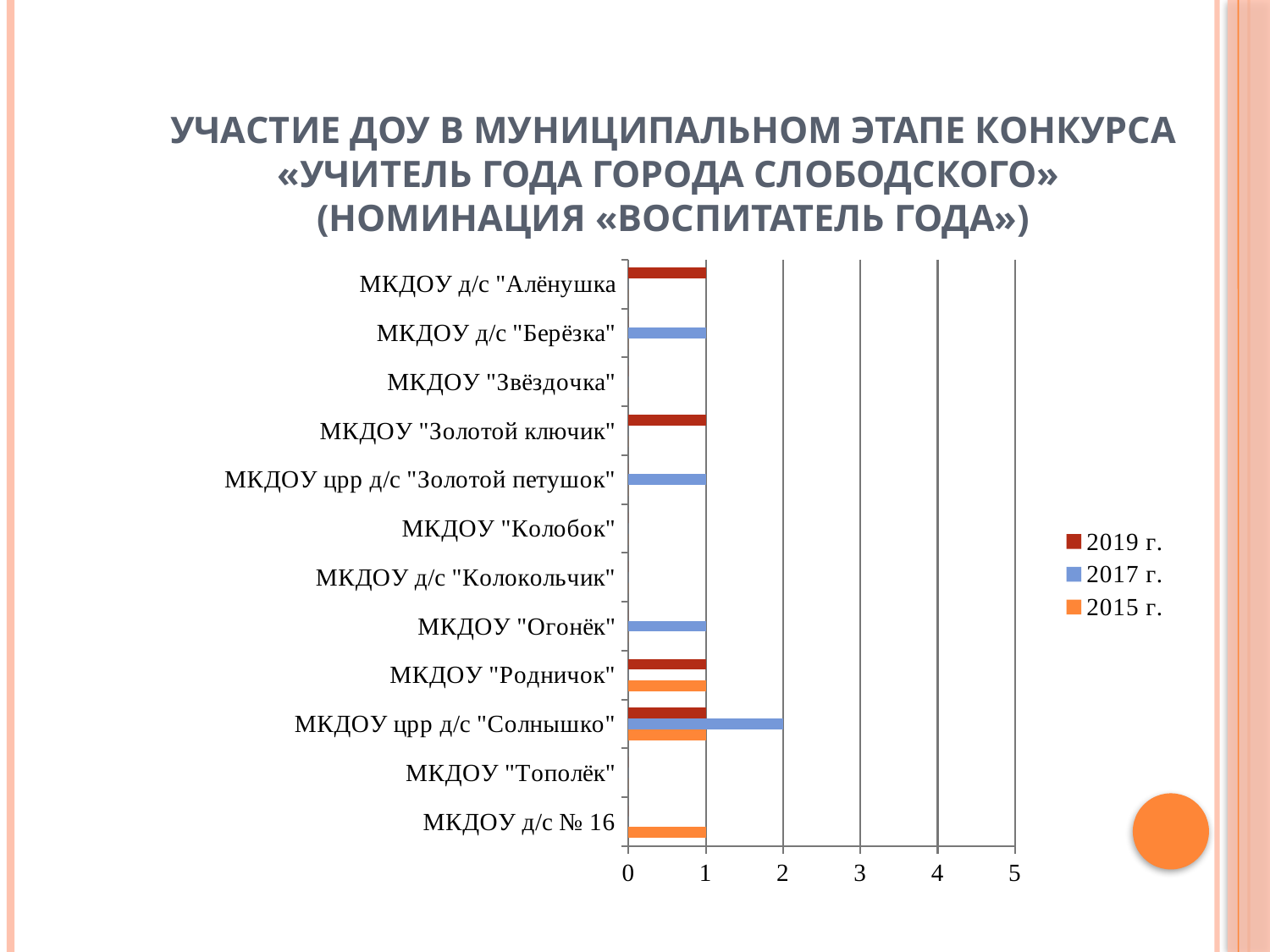
Which is larger: the 2017 г. value for МКДОУ црр д/с "Солнышко" or the 2017 г. value for МКДОУ "Огонёк"? МКДОУ црр д/с "Солнышко" What is the value for МКДОУ црр д/с "Солнышко" in the 2017 г. series? 2 Is the 2017 г. value for МКДОУ црр д/с "Солнышко" greater or less than 3? less What is the difference between the 2017 г. value for МКДОУ црр д/с "Солнышко" and the 2017 г. value for МКДОУ д/с "Берёзка"? 1 What is the value for МКДОУ д/с № 16 in the 2015 г. series? 1 Which series is shown in orange in the legend? 2015 г. What is the value for МКДОУ д/с "Алёнушка" in the 2019 г. series? 1 What kind of chart is shown on the slide? bar chart What is the highest value shown on the horizontal axis? 5 How many series does the legend list? 3 How many categories (institutions) are listed on the vertical axis? 12 Which institution has the highest value in the 2017 г. series? МКДОУ црр д/с "Солнышко"